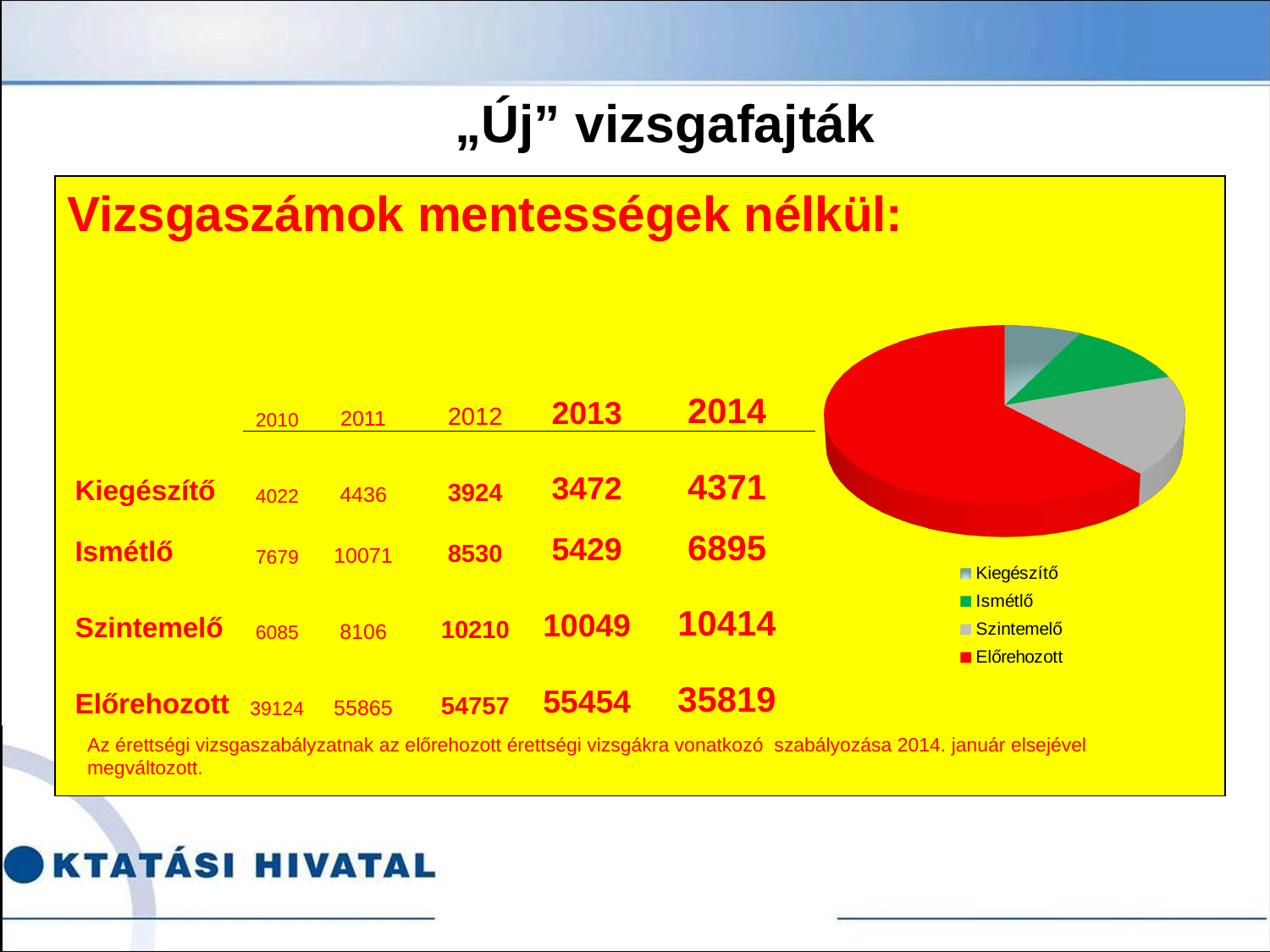
Which colour represents Előrehozott in the pie chart? red Which category has the smallest slice in the pie chart? Kiegészítő What kind of chart is shown on the slide? pie chart In the pie chart, which slice is larger: Szintemelő or Ismétlő? Szintemelő Which category has the largest slice in the pie chart? Előrehozott How many entries does the pie chart's legend list? 4 In the pie chart, which slice is larger: Előrehozott or Szintemelő? Előrehozott How many slices does the pie chart have? 4 Which category is shown in green in the pie chart? Ismétlő